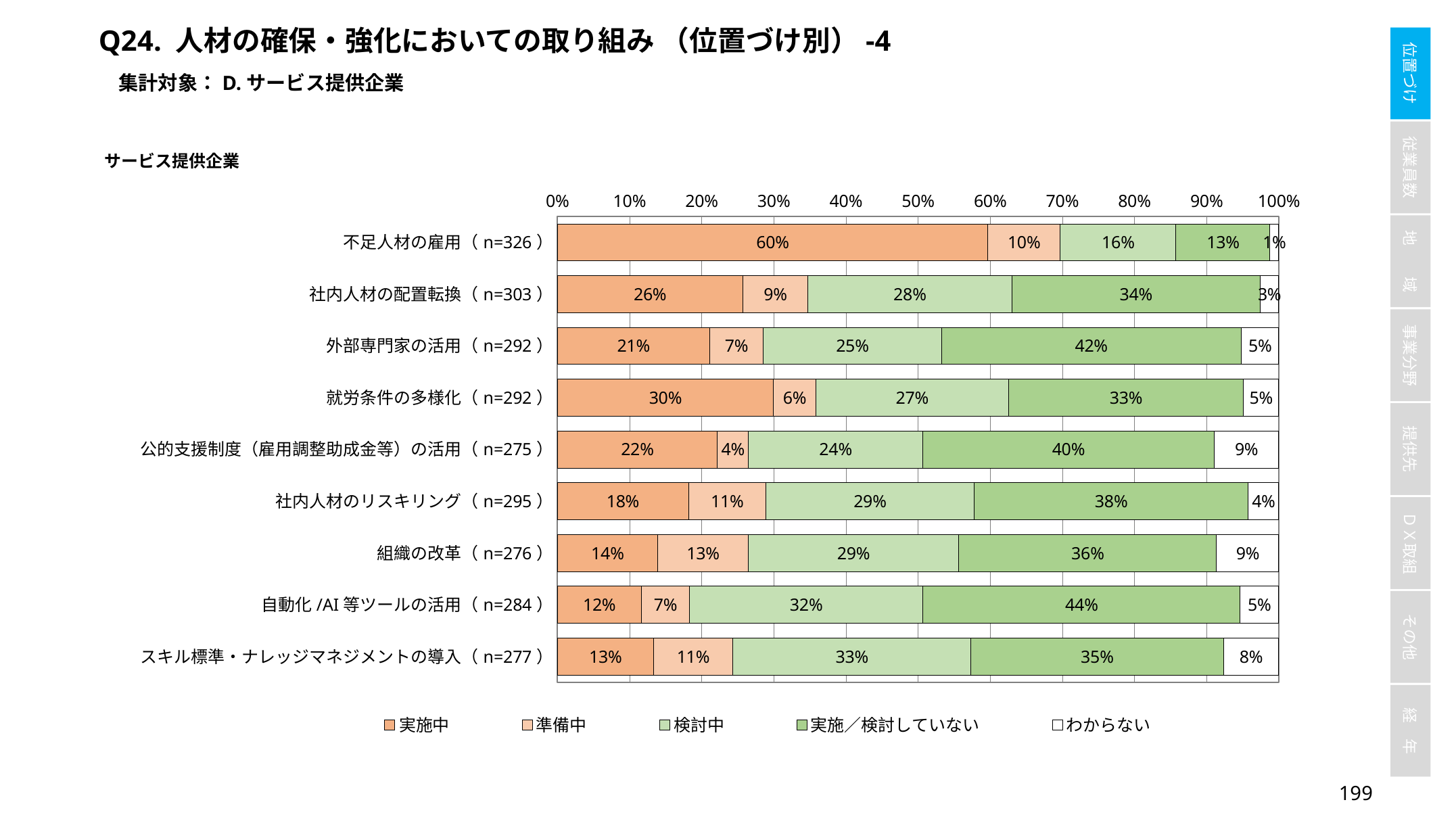
What is the 検討中 value for スキル標準・ナレッジマネジメントの導入? 33% Which is larger: the 実施／検討していない value for 外部専門家の活用 or for 社内人材のリスキリング? 外部専門家の活用 Which category has the lowest 実施中 value? 自動化/AI等ツールの活用 What is the 実施／検討していない value for 自動化/AI等ツールの活用? 44% How many series does the legend list? 5 What is the 実施中 value for 不足人材の雇用? 60% What is the difference between the 実施中 values for 就労条件の多様化 and 外部専門家の活用? 9% Which category has the highest 実施中 value? 不足人材の雇用 What is the 準備中 value for 組織の改革? 13% What type of chart is shown on the slide? Stacked bar chart How many categories (取り組み) are plotted in the chart? 9 What is the sample size (n) shown for 社内人材の配置転換? n=303